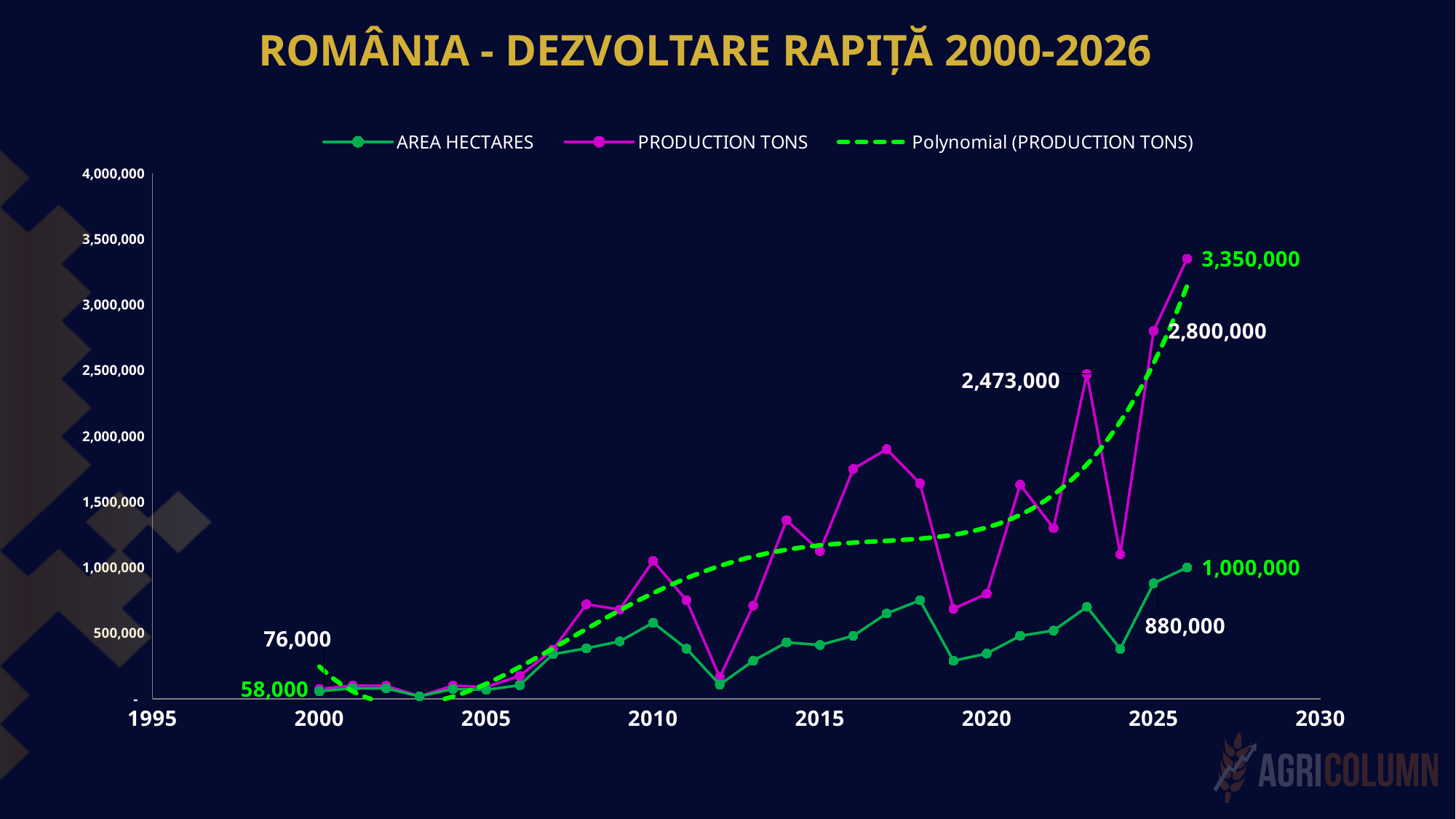
In which year does the PRODUCTION TONS series reach its highest value? 2026 What is the AREA HECTARES value for 2025? 880,000 What is the PRODUCTION TONS value for 2025? 2,800,000 What is the title of the chart? ROMÂNIA - DEZVOLTARE RAPIȚĂ 2000-2026 What is the AREA HECTARES value for 2000? 58,000 What is the PRODUCTION TONS value for 2000? 76,000 What is the AREA HECTARES value for 2026? 1,000,000 By how much did PRODUCTION TONS increase from 2025 to 2026? 550,000 How many series does the legend list? 3 What kind of chart is shown on the slide? line chart What is the PRODUCTION TONS value for 2026? 3,350,000 Is the PRODUCTION TONS value for 2017 greater or less than 1,500,000? greater